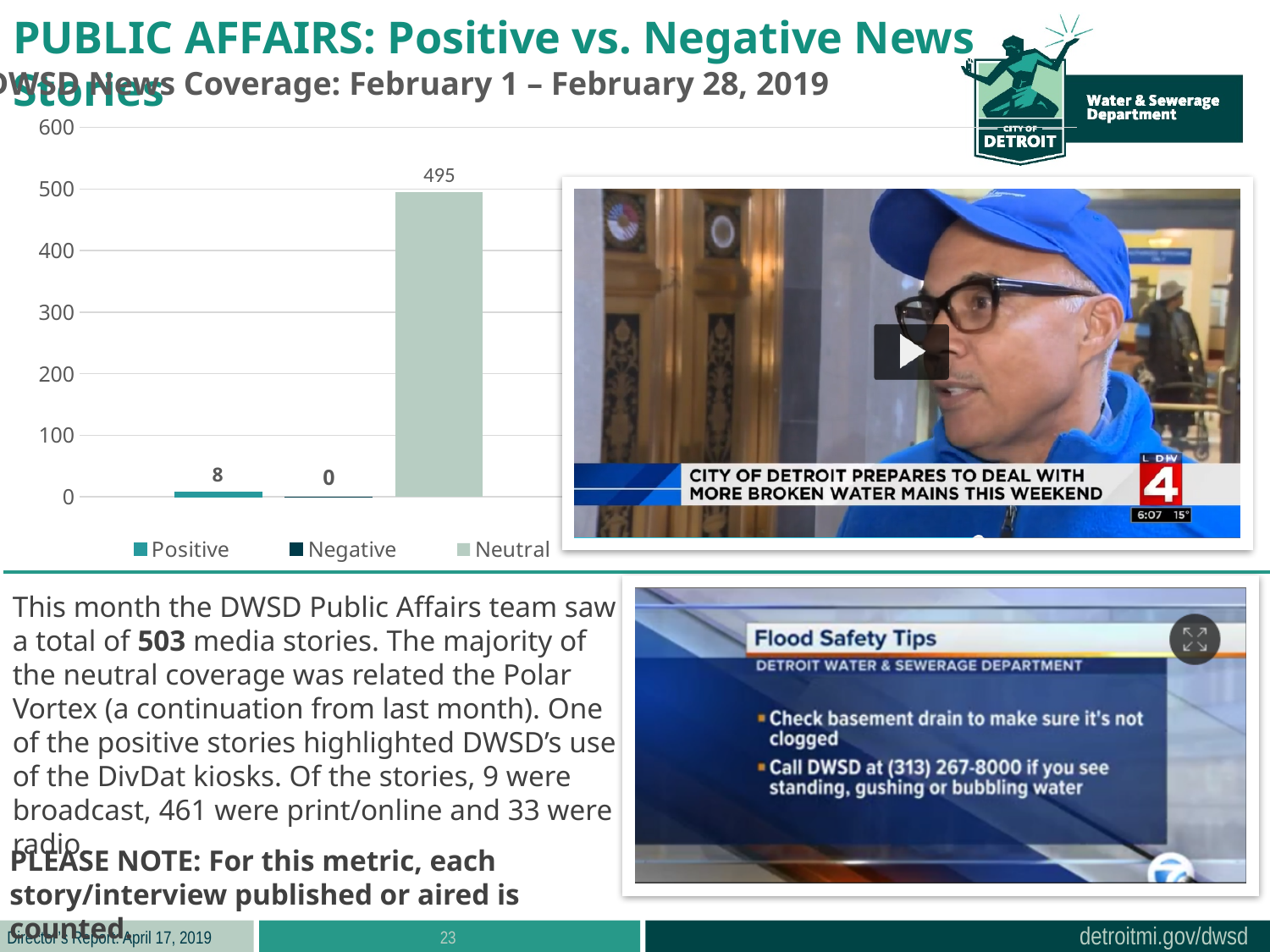
What kind of chart is shown on the slide? Bar chart How many series does the legend list? 3 Is the value for Neutral greater or less than 400? greater What is the value for Negative news stories? 0 What is the difference between the Neutral and Positive values? 487 Which category has the highest value? Neutral What is the value for Neutral news stories? 495 What is the total of the Positive, Negative and Neutral values? 503 Which is larger, the Positive value or the Negative value? Positive Which category has the lowest value? Negative What is the highest value shown on the vertical axis? 600 What is the value for Positive news stories? 8